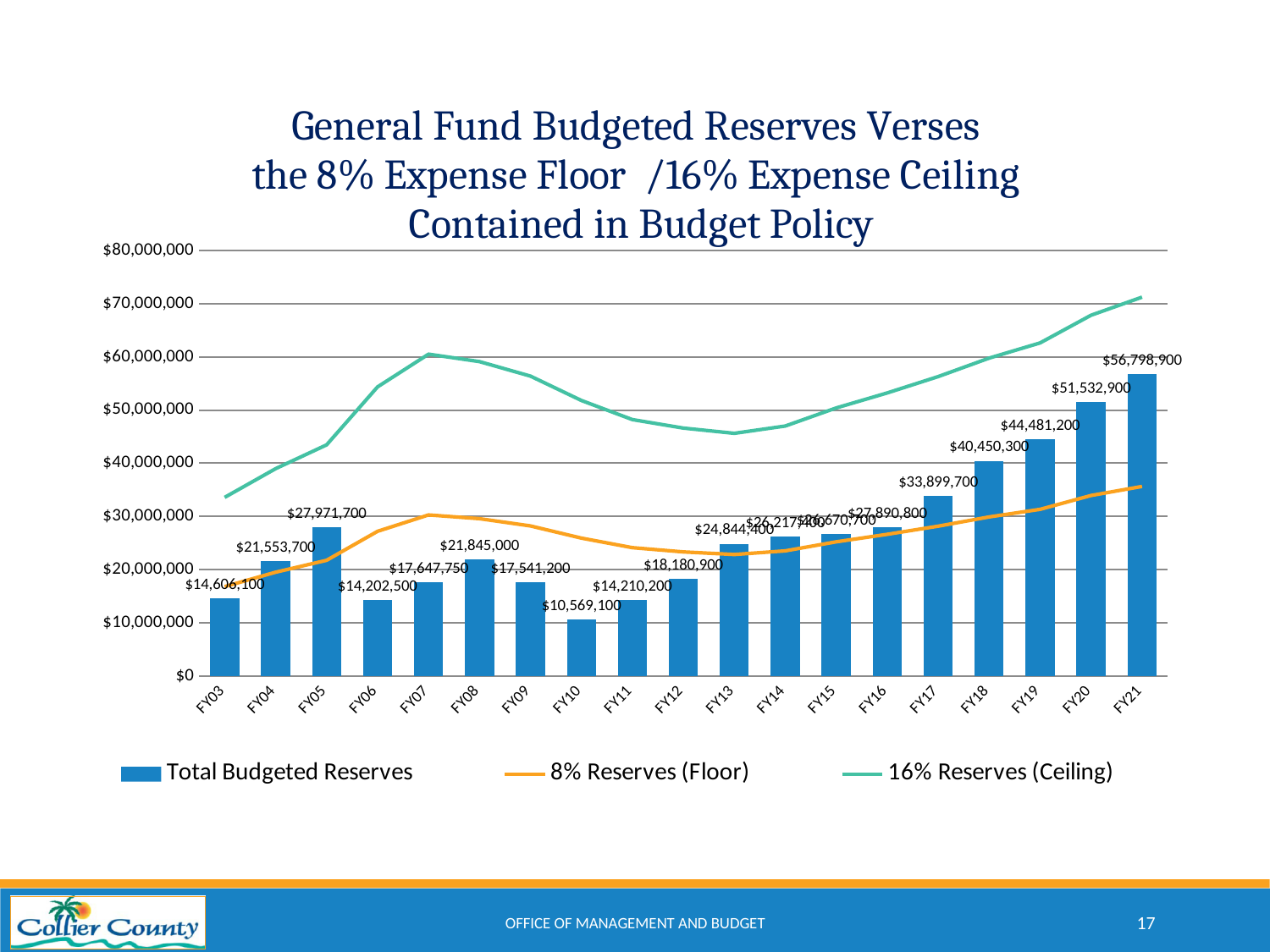
What is the Total Budgeted Reserves value for FY10? $10,569,100 How many series does the legend list? 3 What is the Total Budgeted Reserves value for FY17? $33,899,700 Is the 16% Reserves (Ceiling) value for FY03 greater or less than $40,000,000? less What is the difference in Total Budgeted Reserves between FY21 and FY20? $5,266,000 Which is larger, the Total Budgeted Reserves for FY05 or for FY08? FY05 Is the 16% Reserves (Ceiling) value for FY21 greater or less than $70,000,000? greater Which fiscal year has the highest Total Budgeted Reserves? FY21 How many fiscal years are shown on the x axis? 19 What kind of chart is used to show the Total Budgeted Reserves? Bar chart Which fiscal year has the lowest Total Budgeted Reserves? FY10 What is the Total Budgeted Reserves value for FY21? $56,798,900